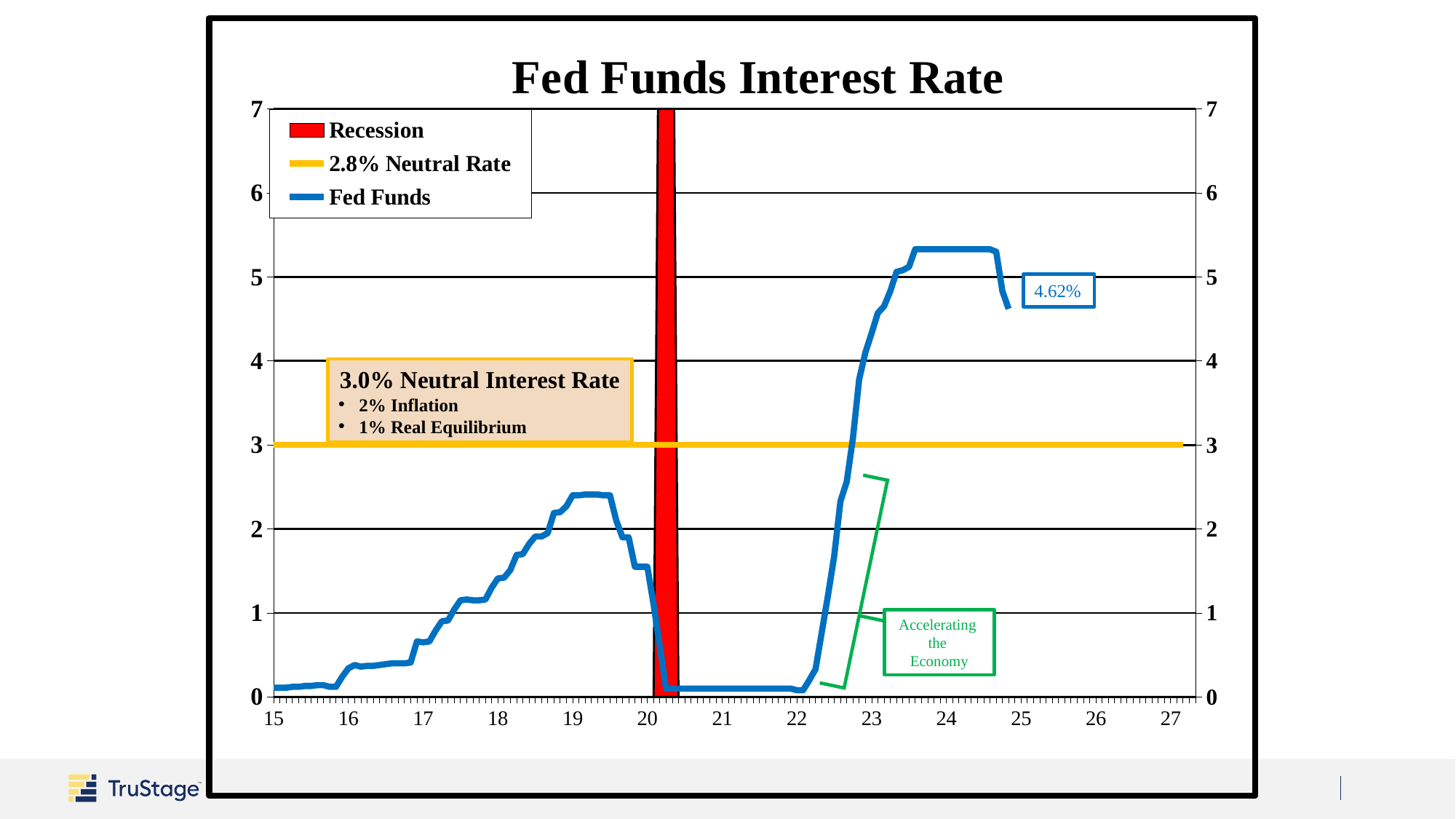
Which is larger, the Fed Funds value at 24 or at 19? 24 Does the Fed Funds line rise or fall between 19.5 and 20.5? fall What value is printed in the data label at the end of the Fed Funds line? 4.62% Is the Fed Funds value at 24 greater or less than 5? greater Is the Fed Funds value at 17 greater or less than 1? less How many entries does the chart's legend list? 3 Does the Fed Funds line rise or fall between 22 and 23? rise What kind of chart is shown on the slide? line chart Is the Fed Funds value at 19 greater or less than 2? greater What is the title of the chart? Fed Funds Interest Rate According to the legend, what does the red shaded bar represent? Recession